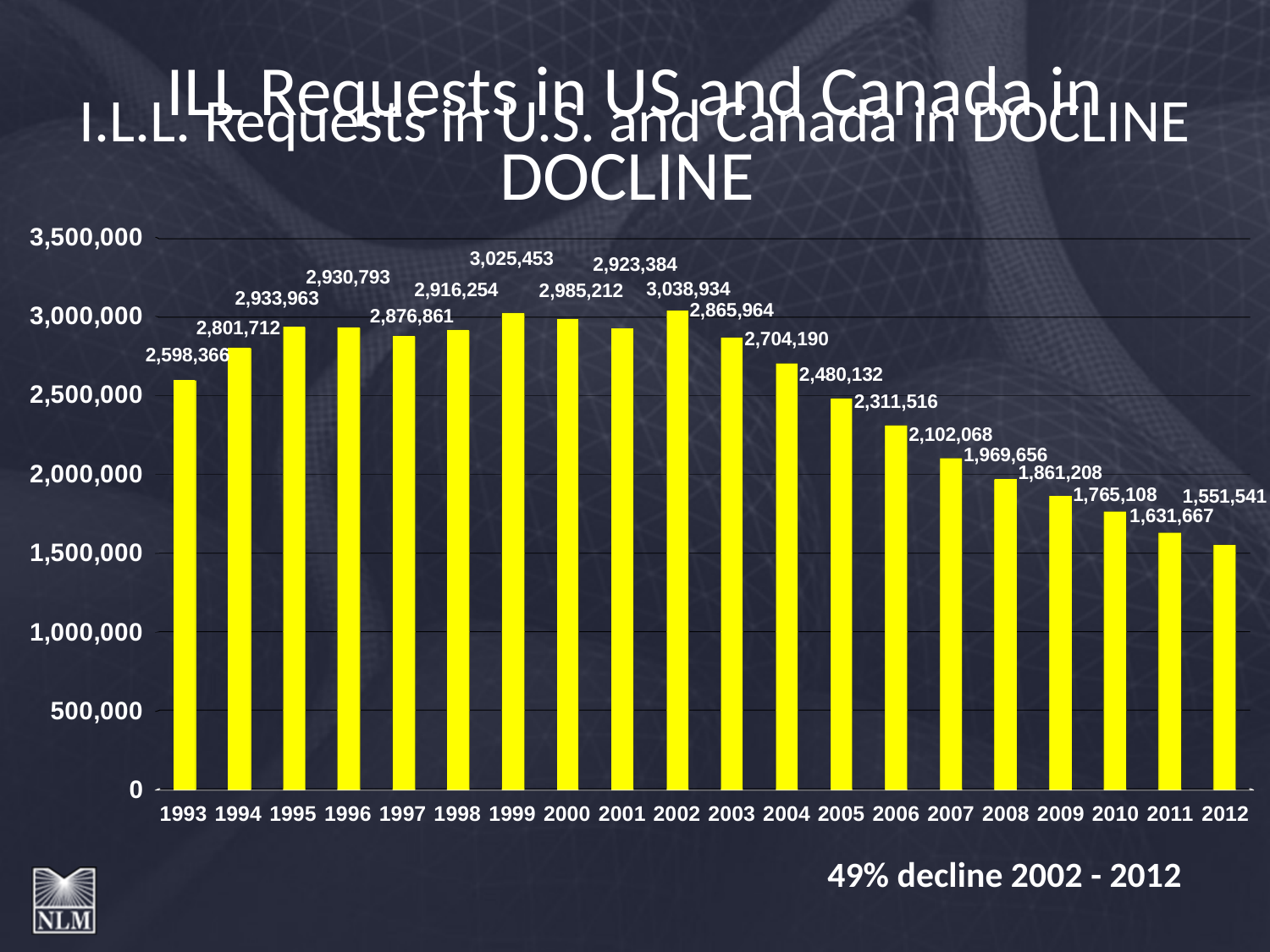
What is the difference between the values for 2002 and 2012? 1,487,393 What kind of chart is shown? bar chart How many years are shown on the x axis? 20 Is the value for 2007 greater or less than 2,500,000? less What is the value for 1993? 2,598,366 Which year has the highest value? 2002 What is the value for 2002? 3,038,934 Which year has the lowest value? 2012 What is the difference between the values for 1994 and 1993? 203,346 What is the value for 2012? 1,551,541 What percentage decline from 2002 to 2012 is noted on the slide? 49% Which is larger, the value for 2004 or the value for 2008? 2004